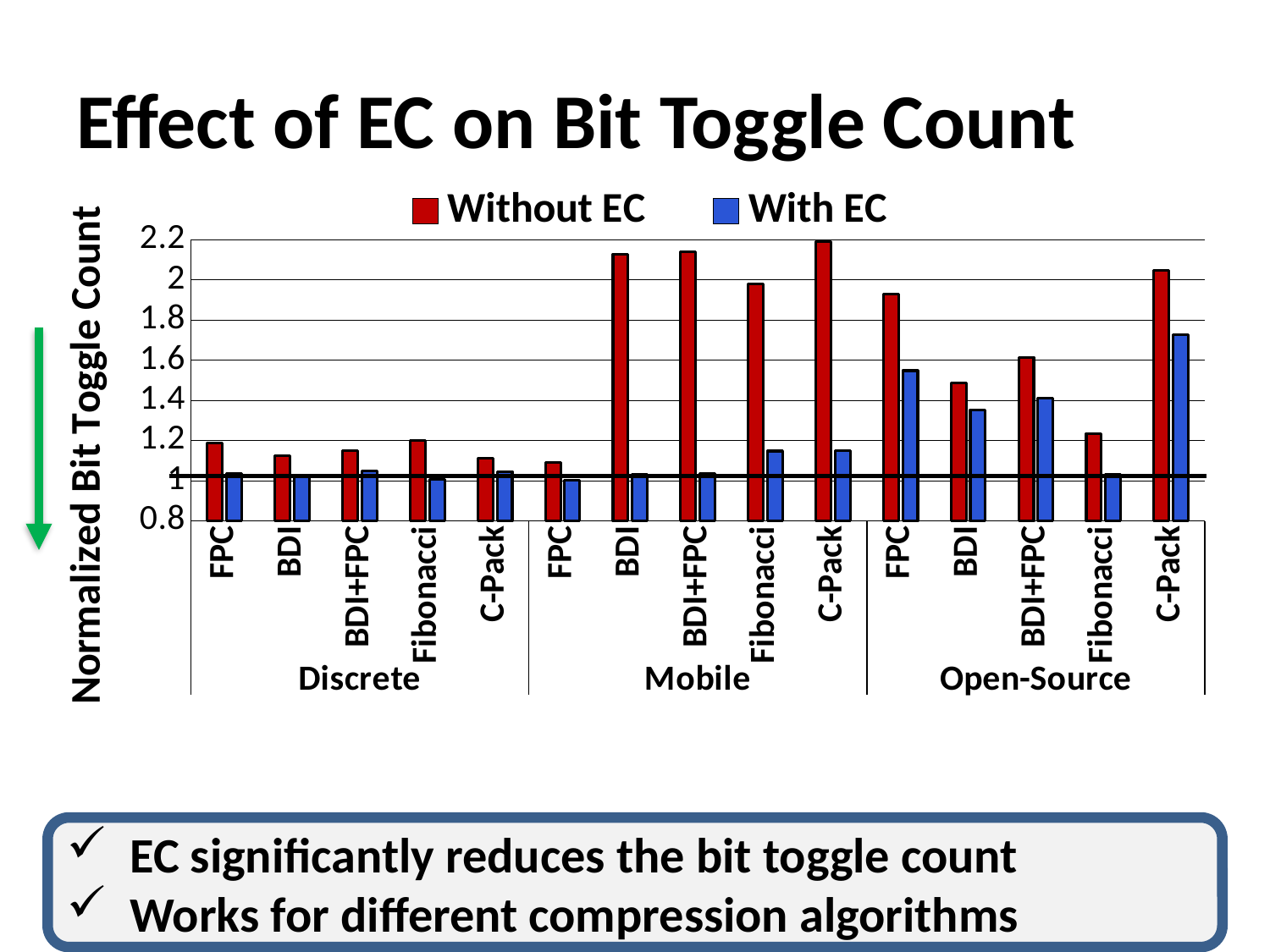
What are the two series named in the legend? Without EC and With EC In the Open-Source group, which has the larger Without EC value, C-Pack or BDI? C-Pack In the Mobile group, which category has the lowest Without EC value? FPC How many series does the legend list? 2 What is the title of the y axis? Normalized Bit Toggle Count What kind of chart is shown on the slide? bar chart Is the With EC value for C-Pack in the Open-Source group greater or less than 1.6? greater How many application groups (Discrete, Mobile, Open-Source) are shown along the x axis? 3 Is the Without EC value for BDI in the Mobile group greater or less than 2? greater Is the Without EC value for Fibonacci in the Discrete group greater or less than 1.4? less How many compression algorithm categories are plotted in total across all groups? 15 Which category has the highest With EC value? C-Pack (Open-Source)